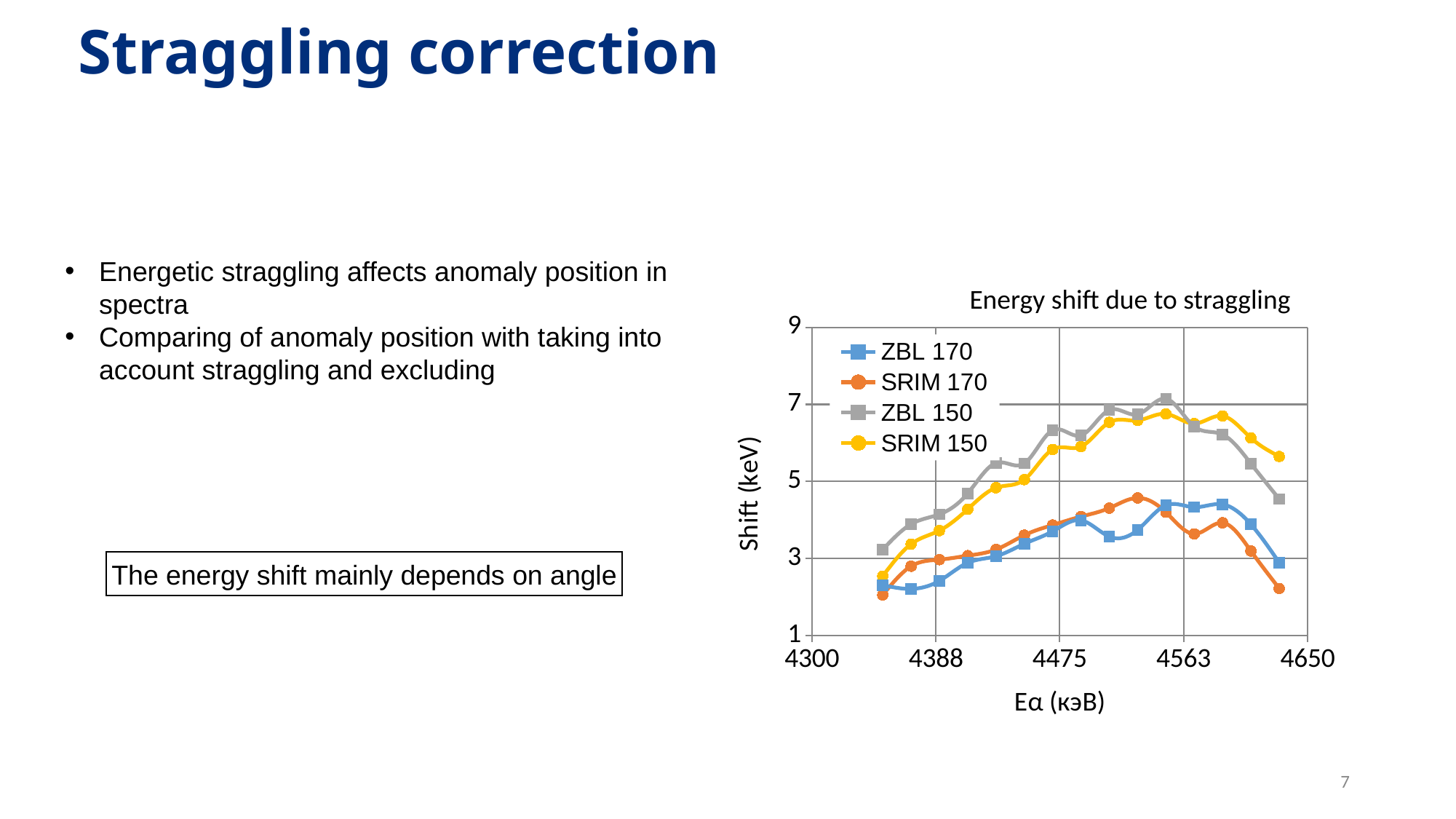
Near 4563, which series has the larger value: ZBL 150 or ZBL 170? ZBL 150 How many series does the legend of the chart list? 4 What is the label of the vertical axis of the chart? Shift (keV) Which series reaches the highest value on the chart? ZBL 150 Do the values of the ZBL 150 series rise or fall between 4388 and 4475 on the x axis? rise Is the value for SRIM 170 at the right end of the chart (near 4650) greater or less than 3? less Is the value for ZBL 170 near 4388 greater or less than 3? less What is the title of the chart? Energy shift due to straggling Do the values of the SRIM 150 series rise or fall between 4563 and 4650 on the x axis? fall Is the value for SRIM 150 near 4563 greater or less than 5? greater What kind of chart is shown on the slide? Line chart